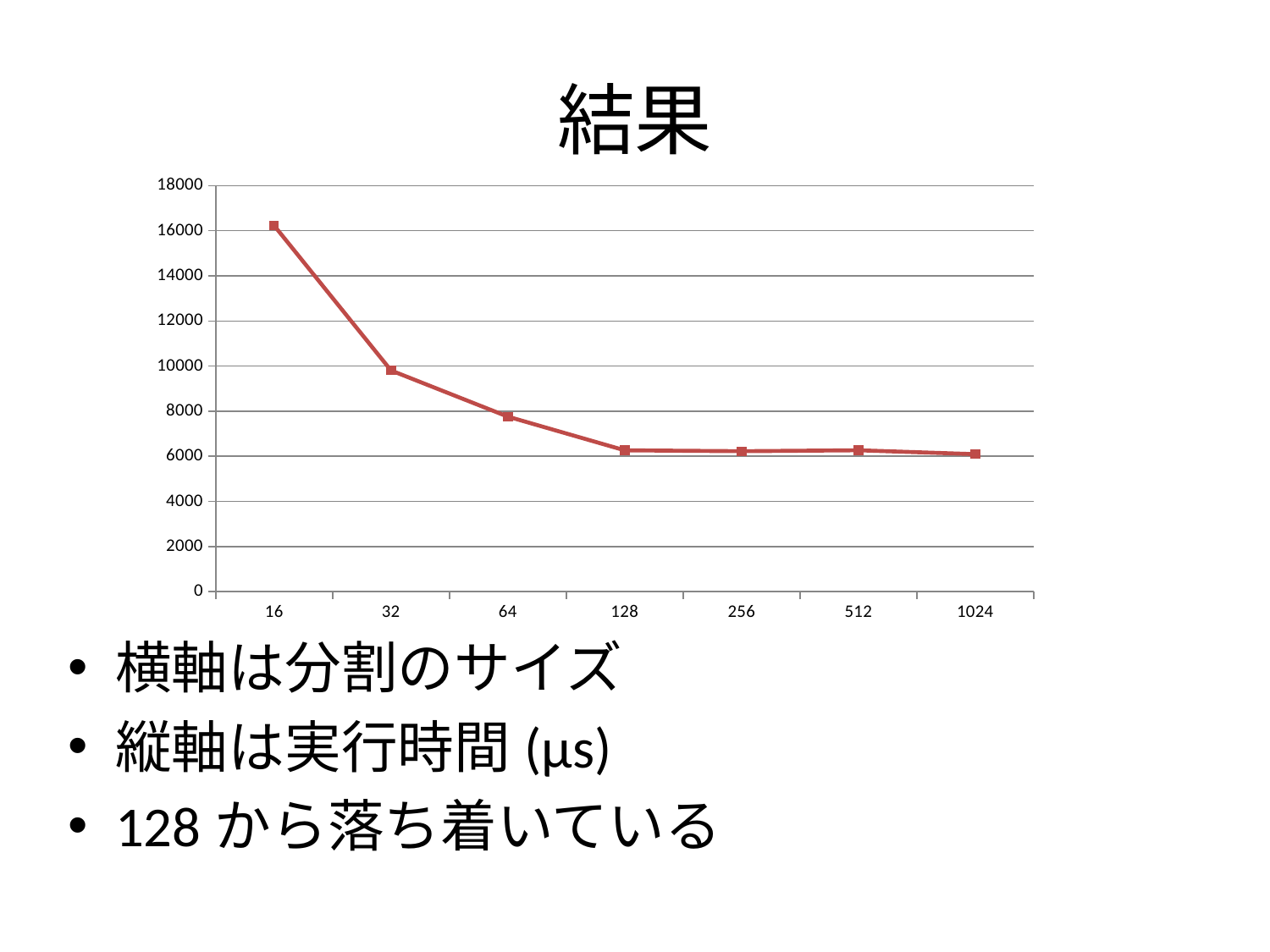
How many data points are plotted on the line? 7 What kind of chart is shown on the slide? line chart Is the value at 16 greater or less than 14000? greater Which has the larger value, 16 or 32? 16 Is the value at 32 greater or less than 12000? less What is the title of the chart? 結果 Is the value at 1024 greater or less than 4000? greater Do the values rise or fall as the x-axis goes from 16 to 1024? fall Which has the larger value, 32 or 64? 32 Which x-axis category has the highest value? 16